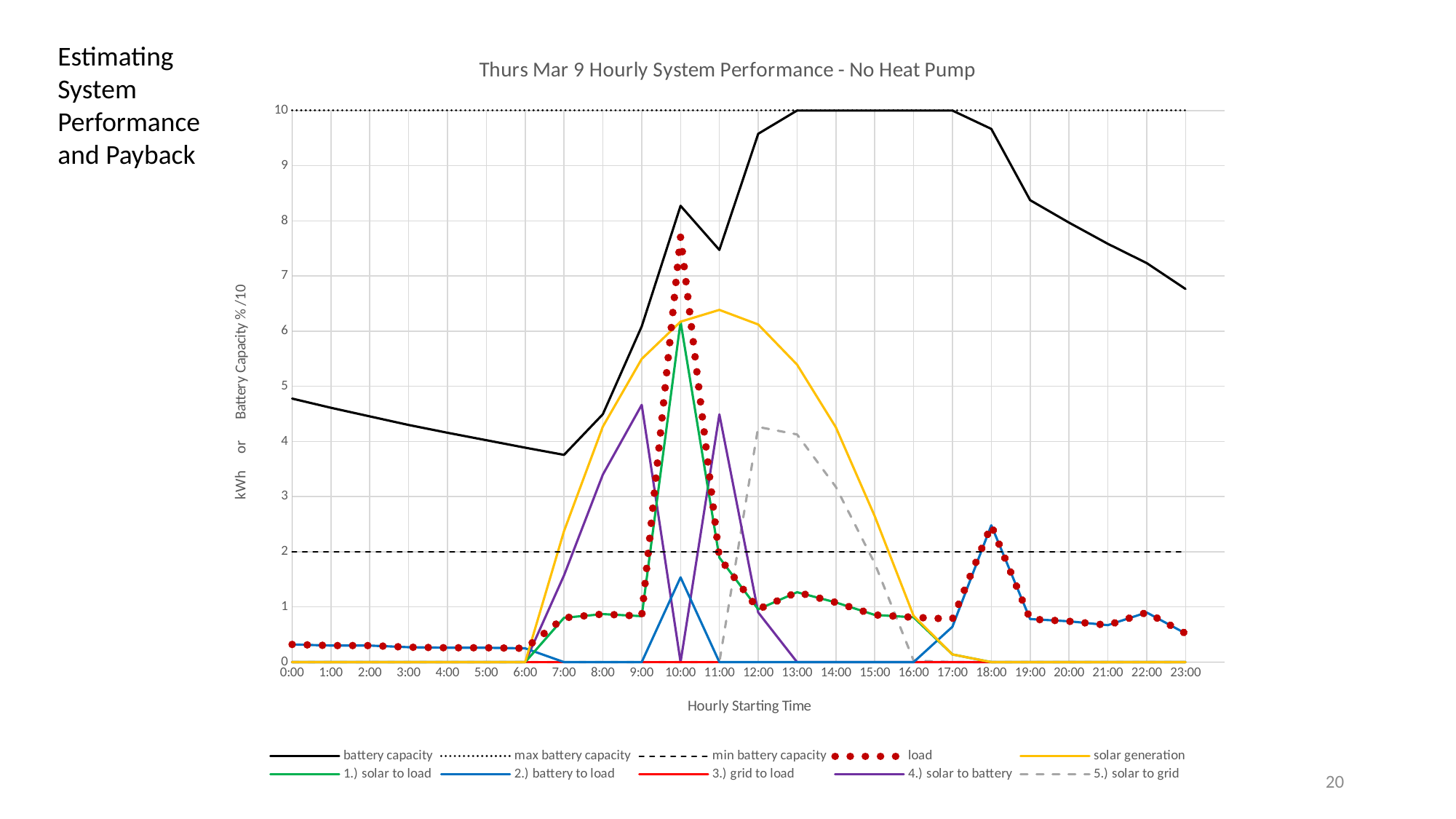
What is the battery capacity value at 14:00? 10 What kind of chart is shown on the slide? line chart Is the battery capacity value at 7:00 greater or less than 4? less Is the load value at 10:00 greater or less than 7? greater Does the battery capacity rise or fall from 18:00 to 23:00? fall What value does the min battery capacity line sit at? 2 At which hour is the load highest? 10:00 What is the title of the chart? Thurs Mar 9 Hourly System Performance - No Heat Pump What value does the max battery capacity line sit at? 10 How many series does the legend list? 10 How many hourly points are plotted along the x axis? 24 At which hour is solar generation highest? 11:00